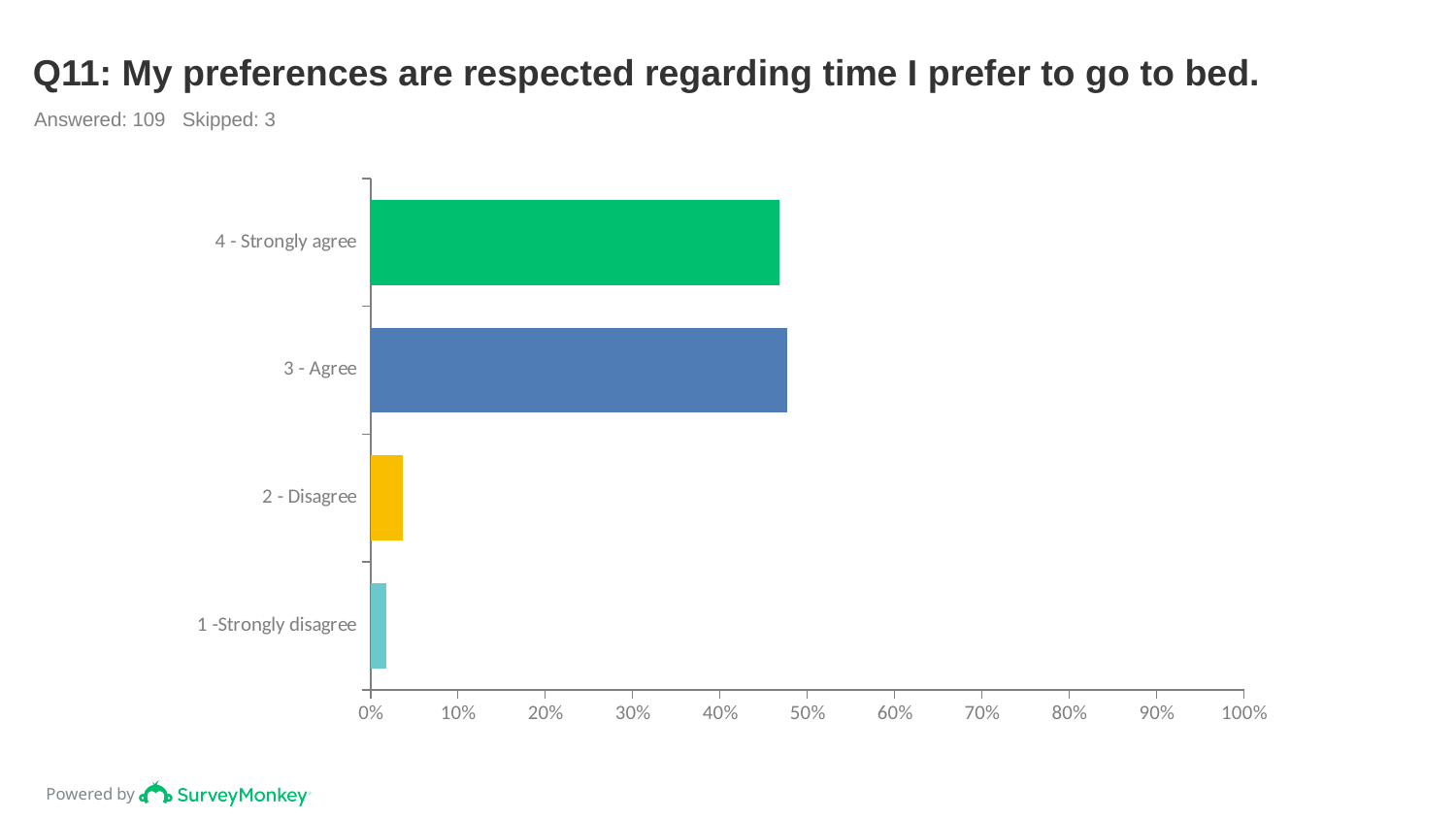
Is the value for "3 - Agree" greater or less than 50%? less Which is larger, the value for "2 - Disagree" or the value for "1 -Strongly disagree"? 2 - Disagree Which category has the lowest value in the chart? 1 -Strongly disagree Is the value for "4 - Strongly agree" greater or less than 50%? less How many respondents answered this question according to the slide? 109 Is the value for "3 - Agree" greater or less than 40%? greater How many response categories are shown in the chart? 4 What kind of chart is shown on the slide? bar chart What is the title of the chart? Q11: My preferences are respected regarding time I prefer to go to bed.